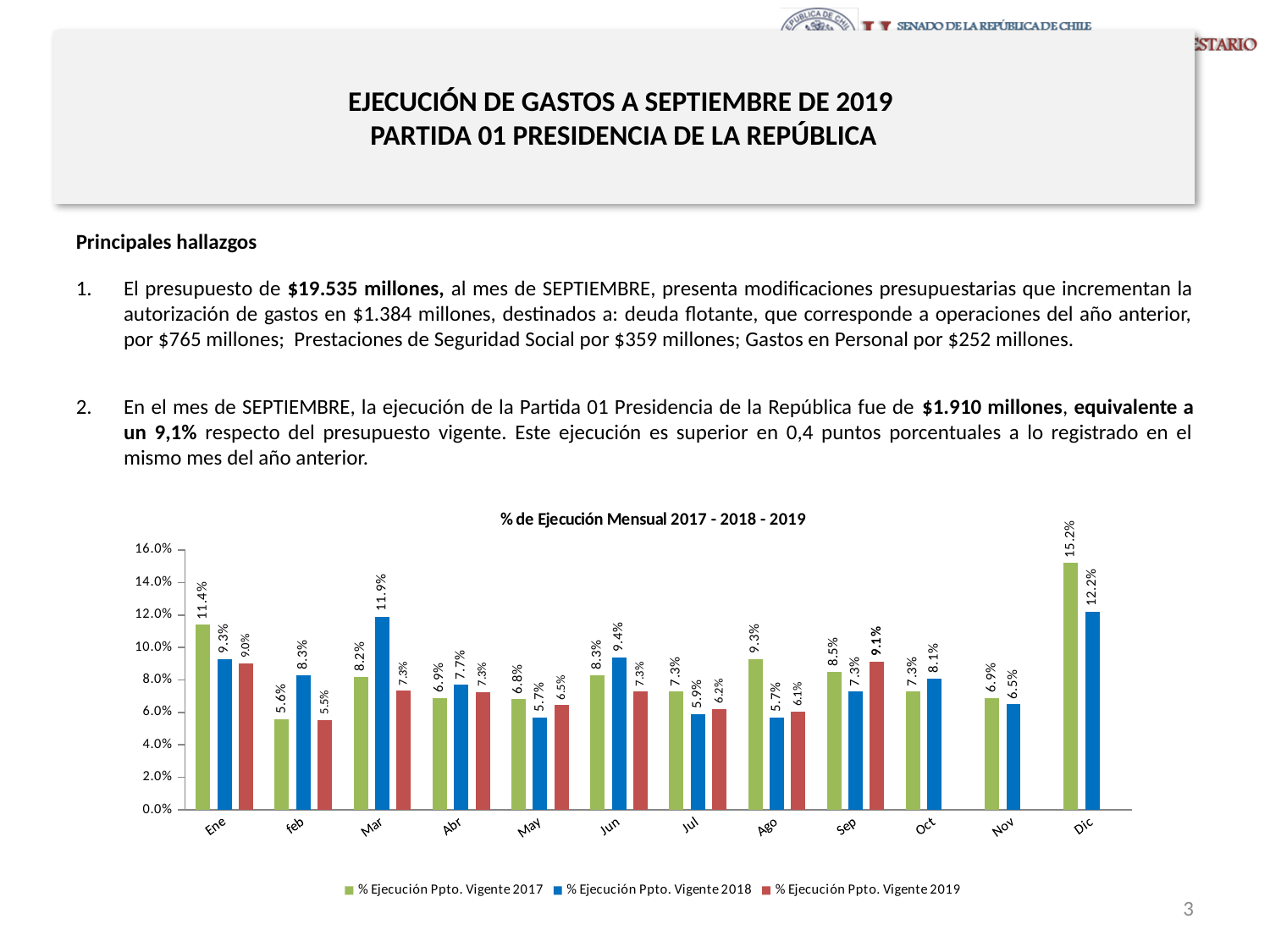
Is the value for Dic in the 2018 series greater or less than 10.0%? greater What is the difference between the 2017 and 2018 values for Ene? 2.1% Which is larger for Ago: the 2017 value or the 2019 value? 2017 value What is the value for Dic in the % Ejecución Ppto. Vigente 2017 series? 15.2% What kind of chart is shown on the slide? Bar chart What is the value for Mar in the % Ejecución Ppto. Vigente 2018 series? 11.9% What is the value for Sep in the % Ejecución Ppto. Vigente 2019 series? 9.1% How many series does the legend list? 3 What is the title of the chart? % de Ejecución Mensual 2017 - 2018 - 2019 Which month has the highest value in the % Ejecución Ppto. Vigente 2018 series? Dic How many months are shown on the x axis? 12 Which month has the lowest value in the % Ejecución Ppto. Vigente 2019 series? feb